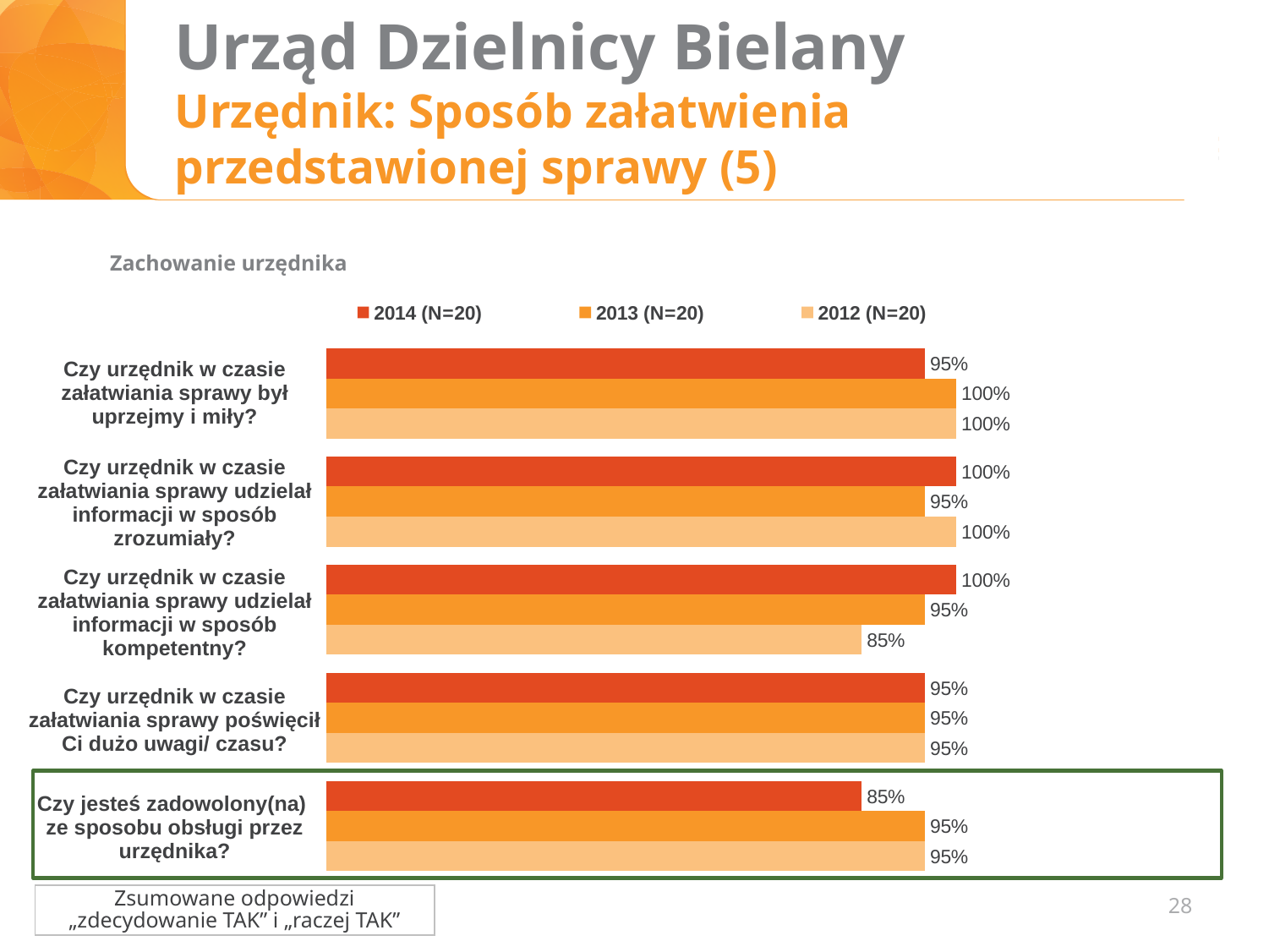
For "Czy jesteś zadowolony(na) ze sposobu obsługi przez urzędnika?", which is larger: the 2014 value or the 2013 value? 2013 (N=20) What is the 2014 (N=20) value for "Czy urzędnik w czasie załatwiania sprawy był uprzejmy i miły?"? 95% How many series does the legend list? 3 What is the 2014 (N=20) value for "Czy jesteś zadowolony(na) ze sposobu obsługi przez urzędnika?"? 85% How many question categories are plotted in the chart? 5 Which year has the highest value for "Czy urzędnik w czasie załatwiania sprawy udzielał informacji w sposób kompetentny?"? 2014 (N=20) Which year has the lowest value for "Czy urzędnik w czasie załatwiania sprawy udzielał informacji w sposób kompetentny?"? 2012 (N=20) What type of chart is shown on the slide? bar chart What is the difference between the 2014 and 2012 values for "Czy urzędnik w czasie załatwiania sprawy udzielał informacji w sposób kompetentny?"? 15% What is the 2013 (N=20) value for "Czy urzędnik w czasie załatwiania sprawy udzielał informacji w sposób zrozumiały?"? 95% What is the 2012 (N=20) value for "Czy urzędnik w czasie załatwiania sprawy udzielał informacji w sposób kompetentny?"? 85% What is the title shown above the chart? Zachowanie urzędnika